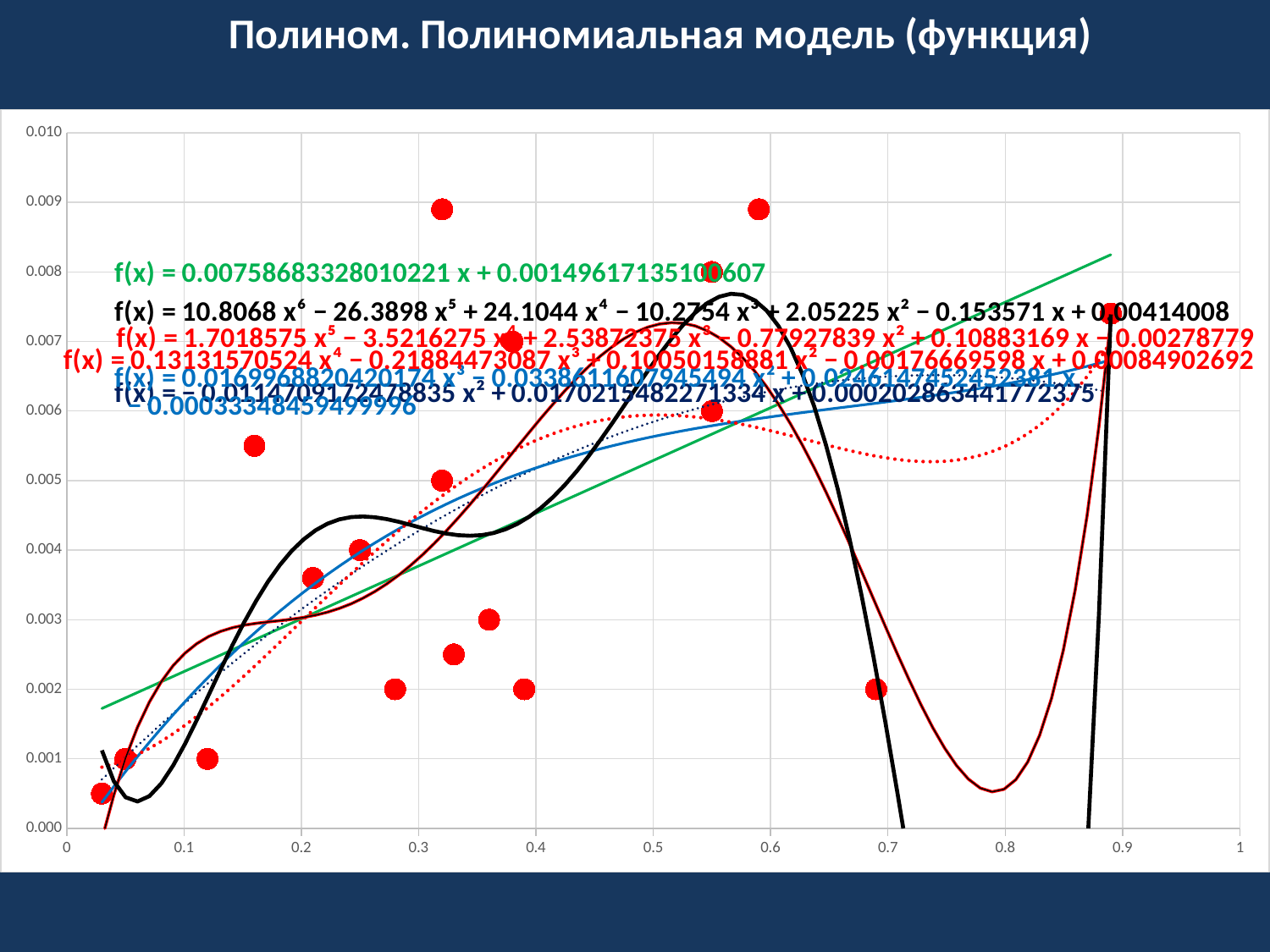
Is the value of the thick black curve at x = 0.7 greater or less than 0.001? less What is the highest power of x in the black trendline equation? x⁶ Does the green straight trendline rise or fall as x increases? rises Is the lowest red scatter point (near x = 0.03) greater or less than 0.001? less What kind of chart is shown on the slide? scatter chart Which is higher: the red scatter point near x = 0.32 at the top of the chart or the red scatter point near x = 0.16? the point near x = 0.32 What is the title of the slide containing the chart? Полином. Полиномиальная модель (функция) Is the peak of the thick black curve near x = 0.57 greater or less than 0.007? greater What is the highest y value reached by any of the red scatter points? 0.009